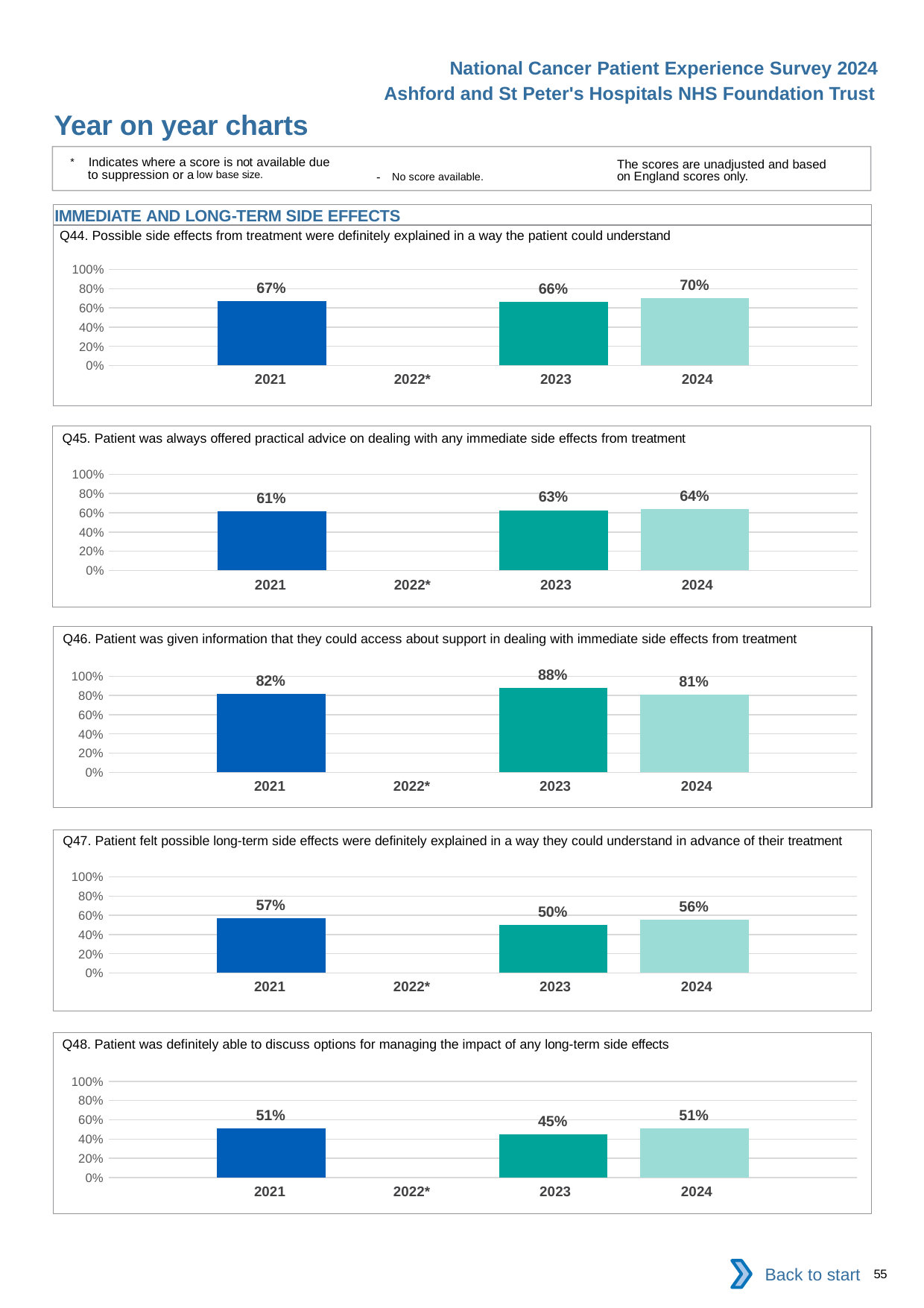
In the Q44 chart, which year has the highest value? 2024 In the Q46 chart, which year has the highest value? 2023 In the Q44 chart, which year has no score shown? 2022* In the Q48 chart, is the value for 2021 or 2023 larger? 2021 In the Q45 chart, what is the value for 2021? 61% In the Q46 chart, what is the value for 2024? 81% In the Q48 chart, what is the value for 2023? 45% In the Q44 chart, what is the value for 2024? 70% In the Q47 chart, what is the difference between the 2021 and 2023 values? 7 percentage points What type of chart is used for Q44? Bar chart In the Q45 chart, what is the difference between the 2024 and 2021 values? 3 percentage points In the Q47 chart, which year has the lowest value? 2023